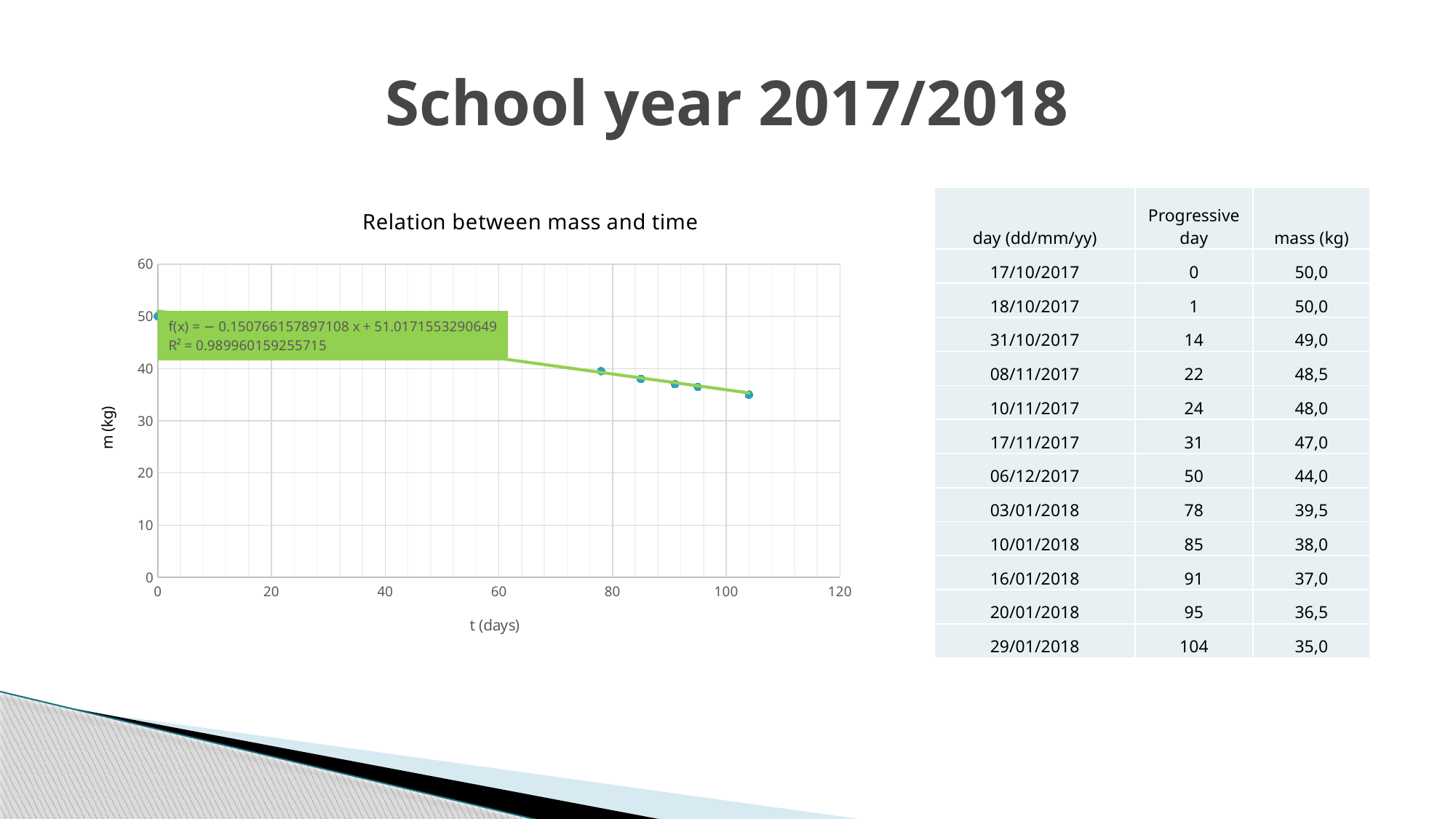
How many data rows (measurement days) does the table list? 12 Is the mass value plotted at t = 0 days greater or less than 40? greater According to the table, what is the lowest mass (kg) recorded? 35,0 What is the label of the x axis of the chart? t (days) What is the difference between the mass on progressive day 0 and the mass on progressive day 104 in the table? 15,0 What is the title of the chart? Relation between mass and time According to the table, what is the mass (kg) on progressive day 78? 39,5 Is the mass value plotted at t = 104 days greater or less than 40? less Do the plotted mass values rise or fall as t (days) increases? Fall What kind of chart is shown on the slide? Scatter chart with a trendline What R² value is shown for the trendline on the chart? 0.989960159255715 According to the table, what is the highest mass (kg) recorded? 50,0